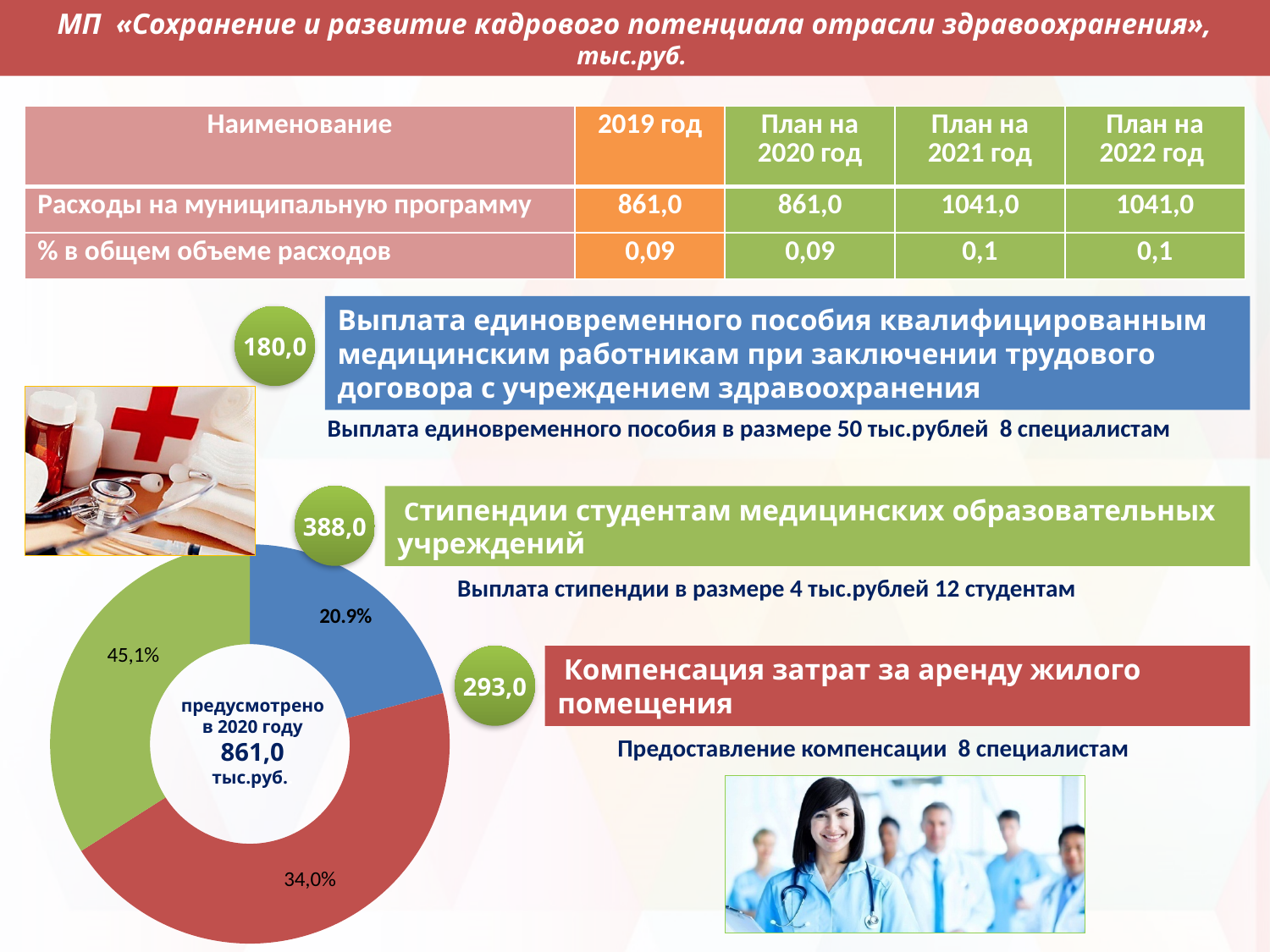
What percentage is shown on the blue slice of the donut chart? 20.9% According to the text in the centre of the donut chart, for which year is the amount planned? 2020 What total amount is written in the centre of the donut chart? 861,0 тыс.руб. Is the red slice or the blue slice of the donut chart larger? Red What is the difference in percentage points between the green slice and the red slice of the donut chart? 11,1 What percentage is shown on the red slice of the donut chart? 34,0% Which colour slice of the donut chart is the smallest? Blue (20.9%) What percentage is shown on the green slice of the donut chart? 45,1% Which colour slice of the donut chart is the largest? Green (45,1%) What kind of chart is shown on the slide? Donut (pie) chart How many slices does the donut chart have? 3 Is the share of the green slice of the donut chart greater or less than 40%? greater